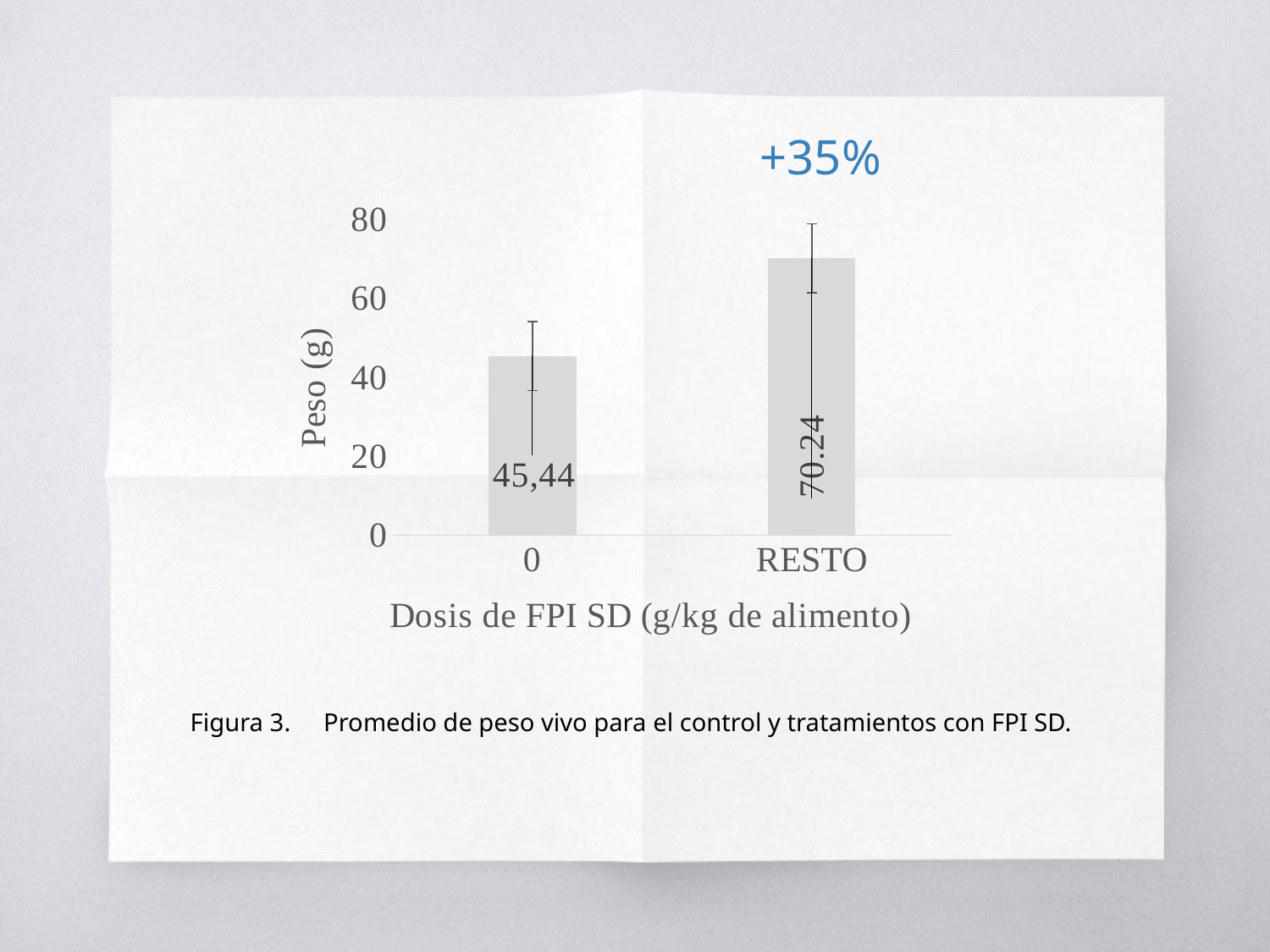
Which is larger, the value for 0 or the value for RESTO? RESTO What kind of chart is shown on the slide? bar chart What is the label of the y axis? Peso (g) Which category has the lowest value? 0 What is the value for the category RESTO? 70.24 How many categories are shown on the x axis? 2 What is the value for the category 0? 45,44 What percentage increase is annotated above the RESTO bar? +35% Is the value for RESTO greater or less than 60? greater Is the value for 0 greater or less than 40? greater Which category has the highest value? RESTO What is the difference between the value for RESTO and the value for 0? 24,80